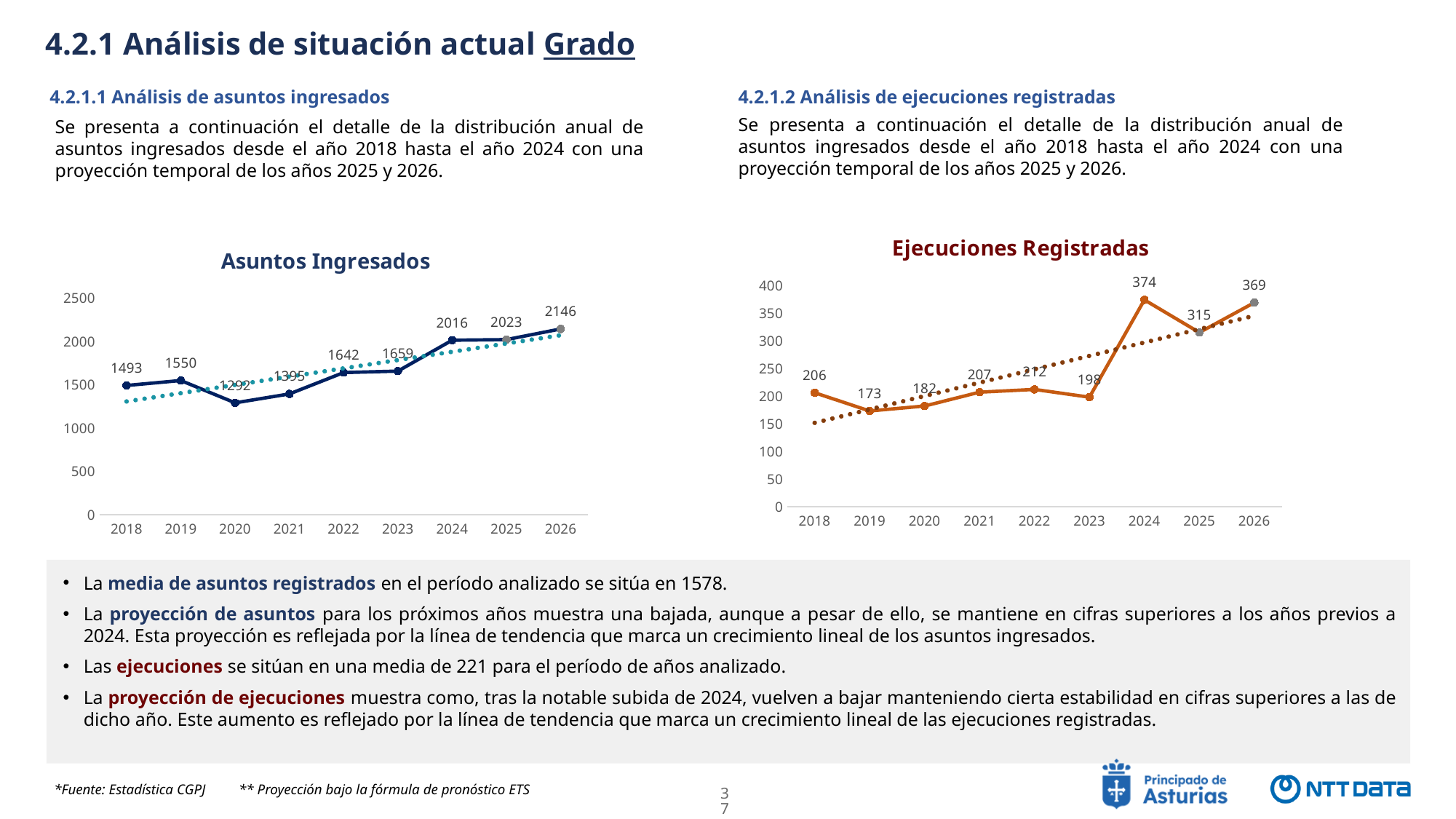
In the 'Ejecuciones Registradas' chart, which year has the lowest value? 2019 In the 'Ejecuciones Registradas' chart, which is larger, the value for 2024 or the value for 2026? 2024 In the 'Ejecuciones Registradas' chart, what is the value for 2019? 173 In the 'Asuntos Ingresados' chart, which year has the highest value? 2026 In the 'Asuntos Ingresados' chart, what is the value for 2018? 1493 In the 'Asuntos Ingresados' chart, what is the difference between the values for 2024 and 2023? 357 In the 'Asuntos Ingresados' chart, how many years are shown on the x axis? 9 In the 'Asuntos Ingresados' chart, what is the value for 2024? 2016 What type of chart is 'Ejecuciones Registradas'? Line chart In the 'Asuntos Ingresados' chart, which year has the lowest value? 2020 In the 'Ejecuciones Registradas' chart, what is the value for 2024? 374 In the 'Ejecuciones Registradas' chart, what is the difference between the values for 2024 and 2025? 59